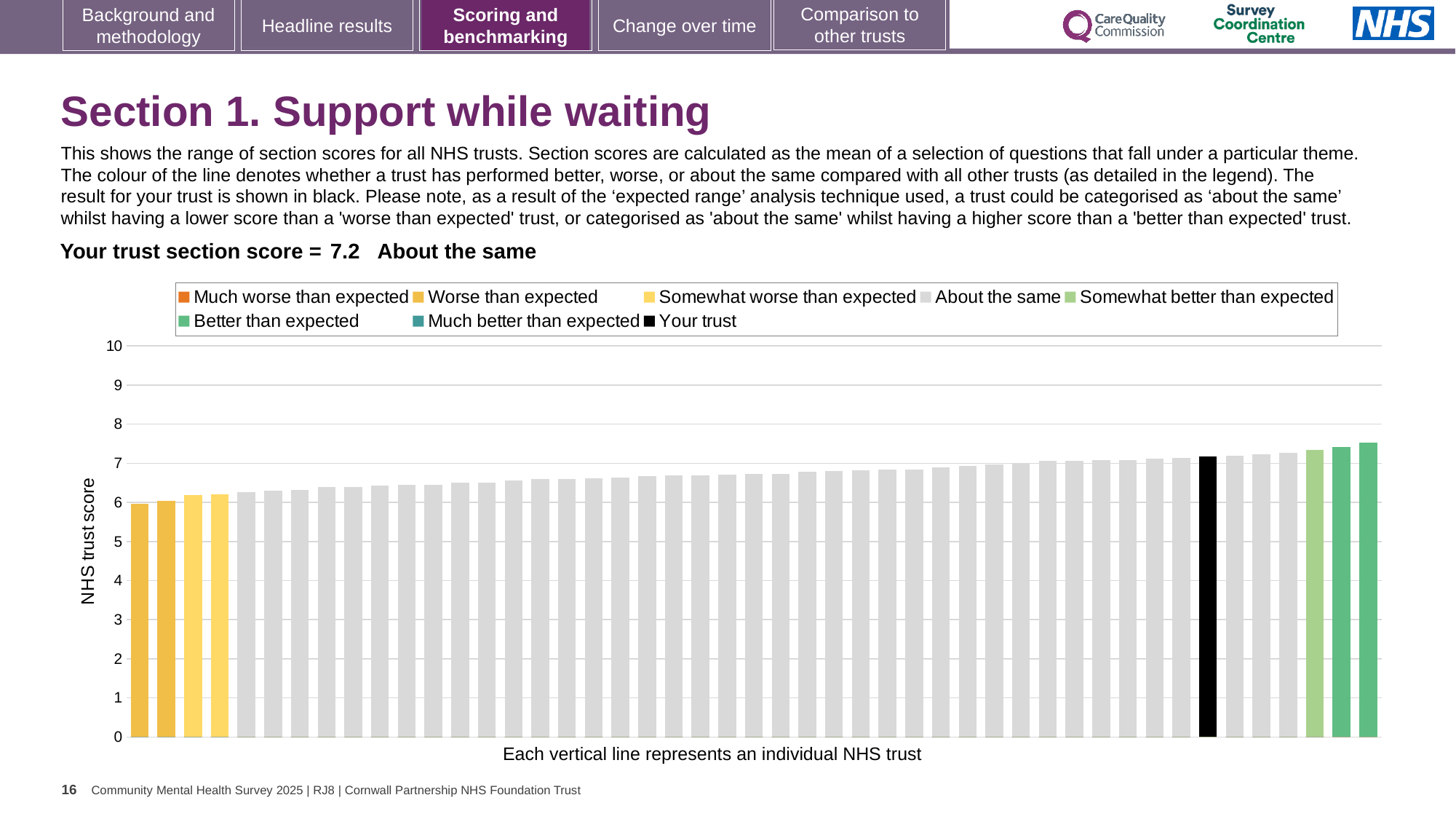
What is the title of the vertical axis? NHS trust score How many entries does the chart legend list? 8 Is the value of the tallest bar greater or less than 8? less Is the value of the leftmost bar greater or less than 7? less What kind of chart is shown on the slide? Bar chart Which is higher, the black 'Your trust' bar or the leftmost bar? The black 'Your trust' bar What is the section score for your trust shown on the slide? 7.2 Is the value of the black 'Your trust' bar greater or less than 7? greater How many bars are coloured green (better than expected)? 3 Which is higher, the black 'Your trust' bar or the rightmost bar? The rightmost bar Do the bar values rise or fall from left to right along the x axis? rise What colour is the bar representing your trust? Black